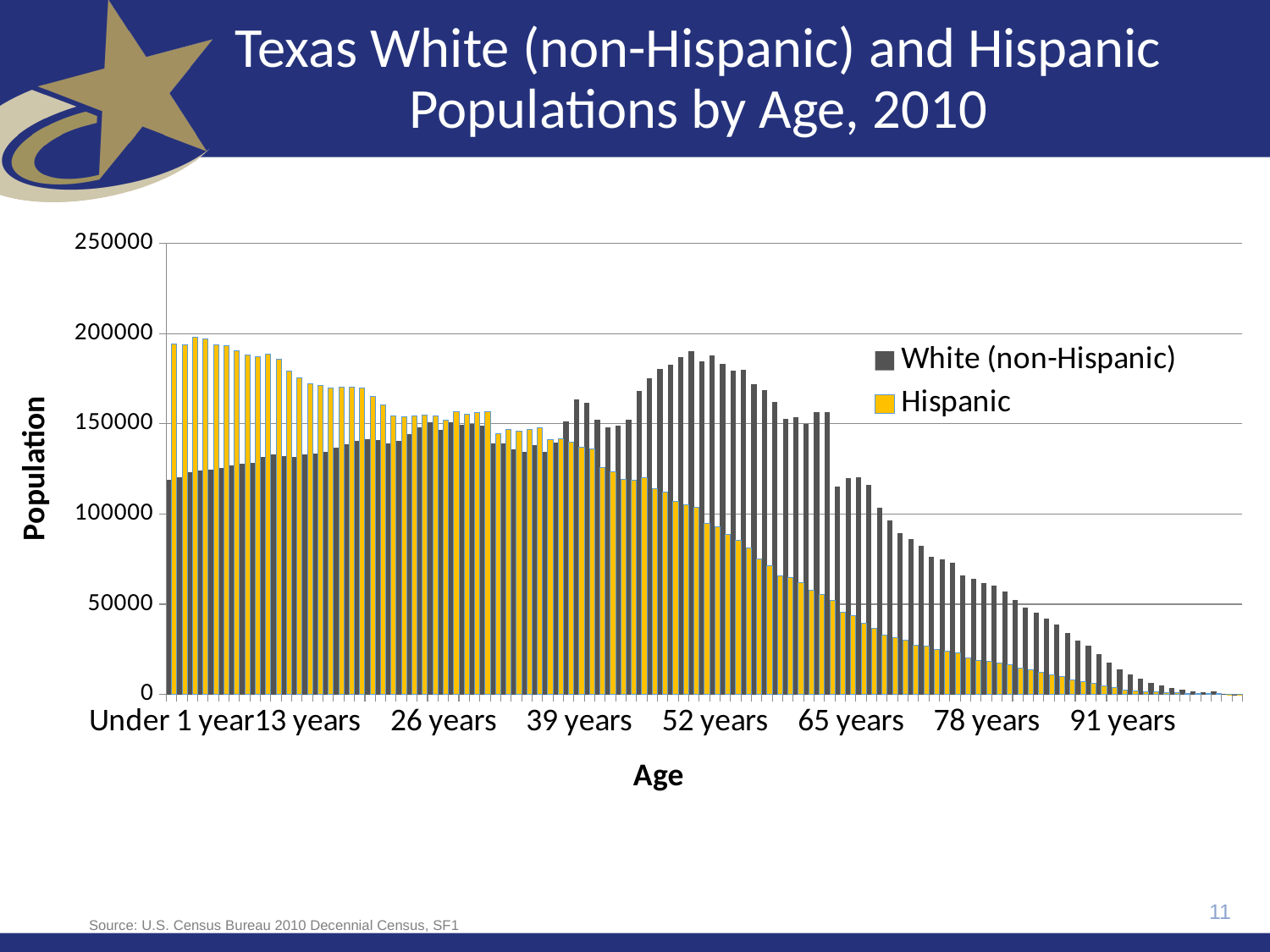
Does the Hispanic population rise or fall from 52 years to 91 years? fall At Under 1 year, which series has the larger population, White (non-Hispanic) or Hispanic? Hispanic At 52 years, which series has the larger population, White (non-Hispanic) or Hispanic? White (non-Hispanic) Is the Hispanic population at 65 years greater or less than 100000? less What kind of chart is shown on the slide? bar chart How many series does the legend list? 2 Is the White (non-Hispanic) population at 52 years greater or less than 150000? greater Is the White (non-Hispanic) population for Under 1 year greater or less than 150000? less Which colour represents the Hispanic series in the chart? yellow What is the title of the chart? Texas White (non-Hispanic) and Hispanic Populations by Age, 2010